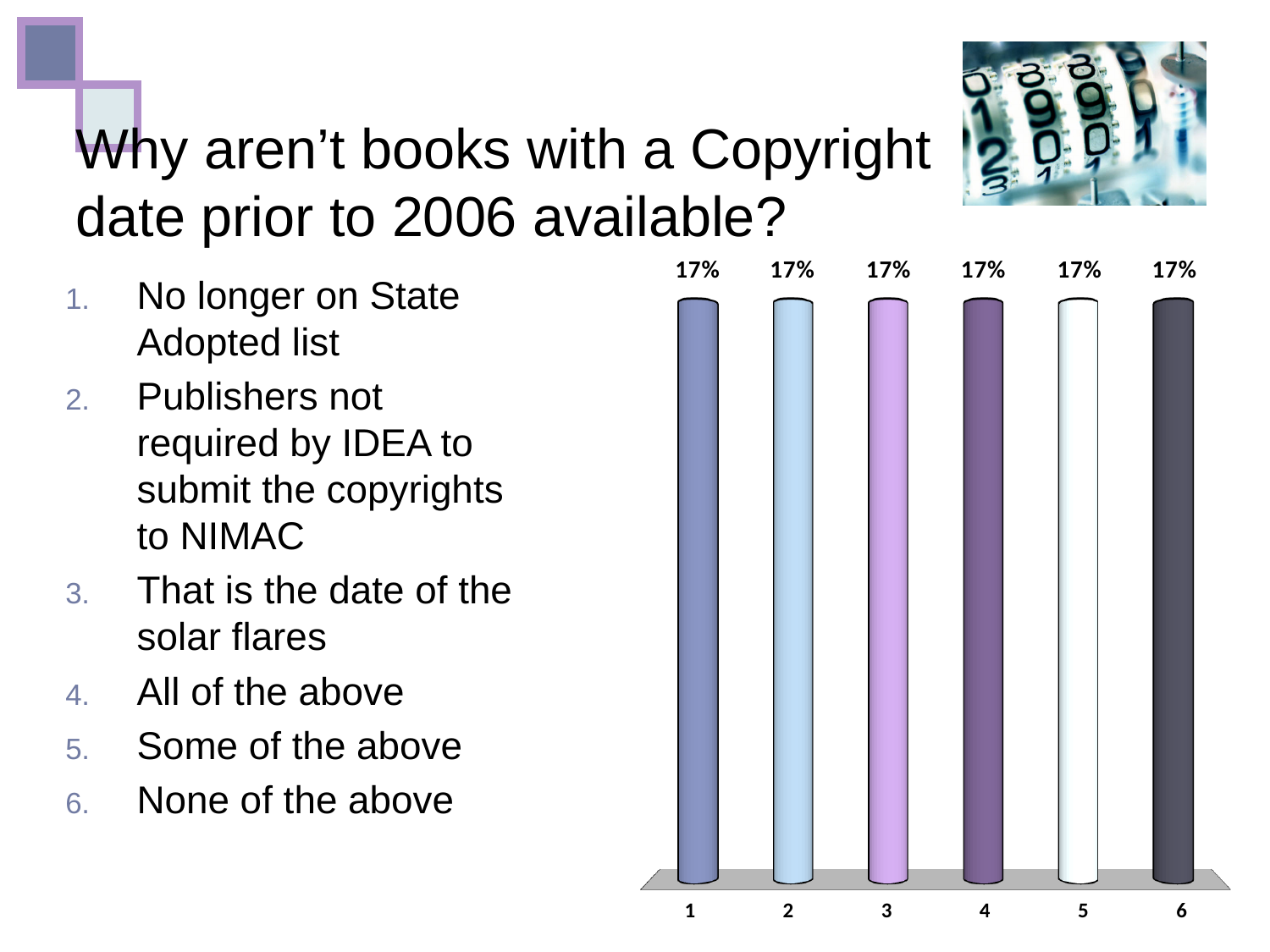
What is the value shown for category 6? 17% What is the value shown for category 4? 17% Are all six bars labelled with the same value? yes What label appears on the x axis under the last bar? 6 How many bars does the chart show? 6 What kind of chart is shown on the slide? bar chart What is the difference between the values for category 2 and category 5? 0% What is the value shown for category 1? 17% Do the values rise, fall, or stay the same across categories 1 to 6? stay the same